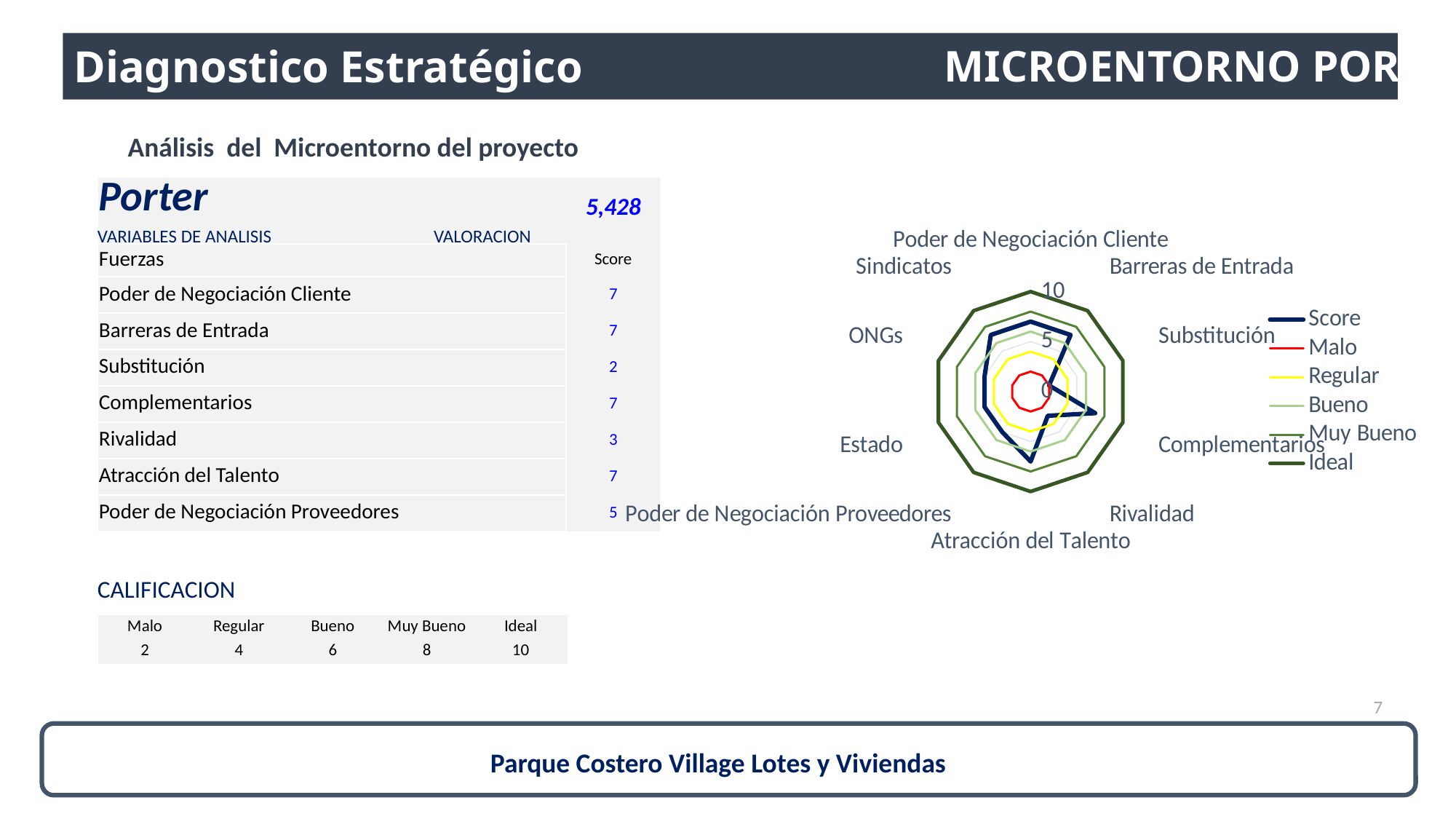
What is the Score value for Rivalidad? 3 How many series does the legend of the radar chart list? 6 Which category has the lowest Score value in the radar chart? Substitución Is the Score value for Poder de Negociación Cliente greater or less than 5? greater Is the Score value for Substitución greater or less than 5? less Is the Score value for Barreras de Entrada greater or less than 5? greater Which series in the radar chart is drawn in red? Malo How many categories (axes) does the radar chart have? 10 Which series in the radar chart is drawn as the outermost polygon? Ideal What kind of chart is shown on the slide? radar chart Which has a larger Score value, Barreras de Entrada or Substitución? Barreras de Entrada What is the Score value for Substitución? 2